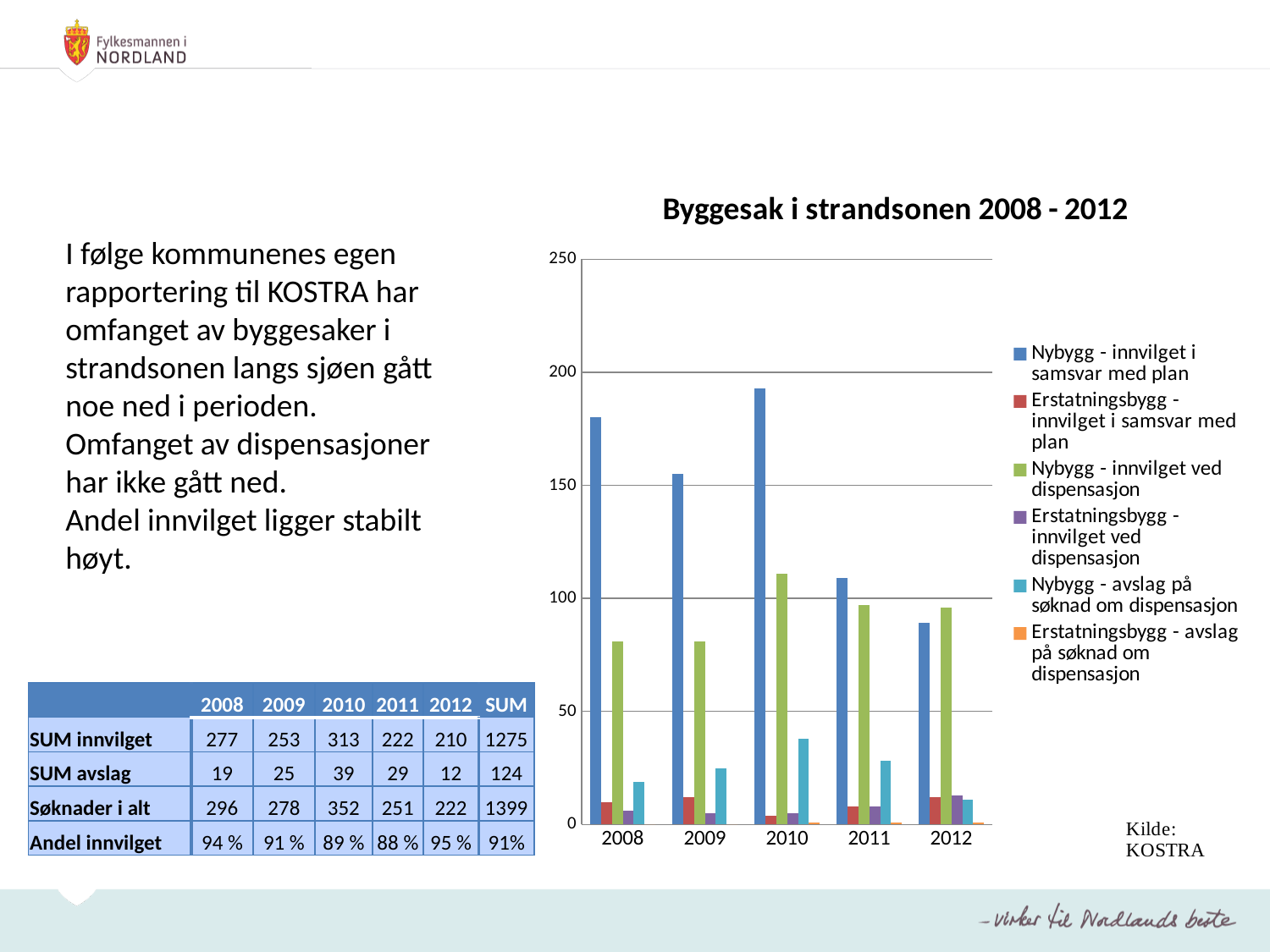
Is the value for 'Nybygg - innvilget i samsvar med plan' in 2012 greater or less than 100? less In which year is the value for 'Nybygg - innvilget i samsvar med plan' highest? 2010 Which year has the larger value for 'Nybygg - innvilget i samsvar med plan', 2008 or 2009? 2008 Is the value for 'Nybygg - avslag på søknad om dispensasjon' in 2010 greater or less than 50? less How many series does the chart legend list? 6 How many years are shown on the x axis of the chart? 5 In which year is the value for 'Nybygg - innvilget i samsvar med plan' lowest? 2012 Does the value for 'Nybygg - innvilget i samsvar med plan' rise or fall from 2010 to 2012? fall Is the value for 'Nybygg - innvilget ved dispensasjon' in 2010 greater or less than 100? greater What is the title of the chart? Byggesak i strandsonen 2008 - 2012 What kind of chart is shown on the slide? bar chart